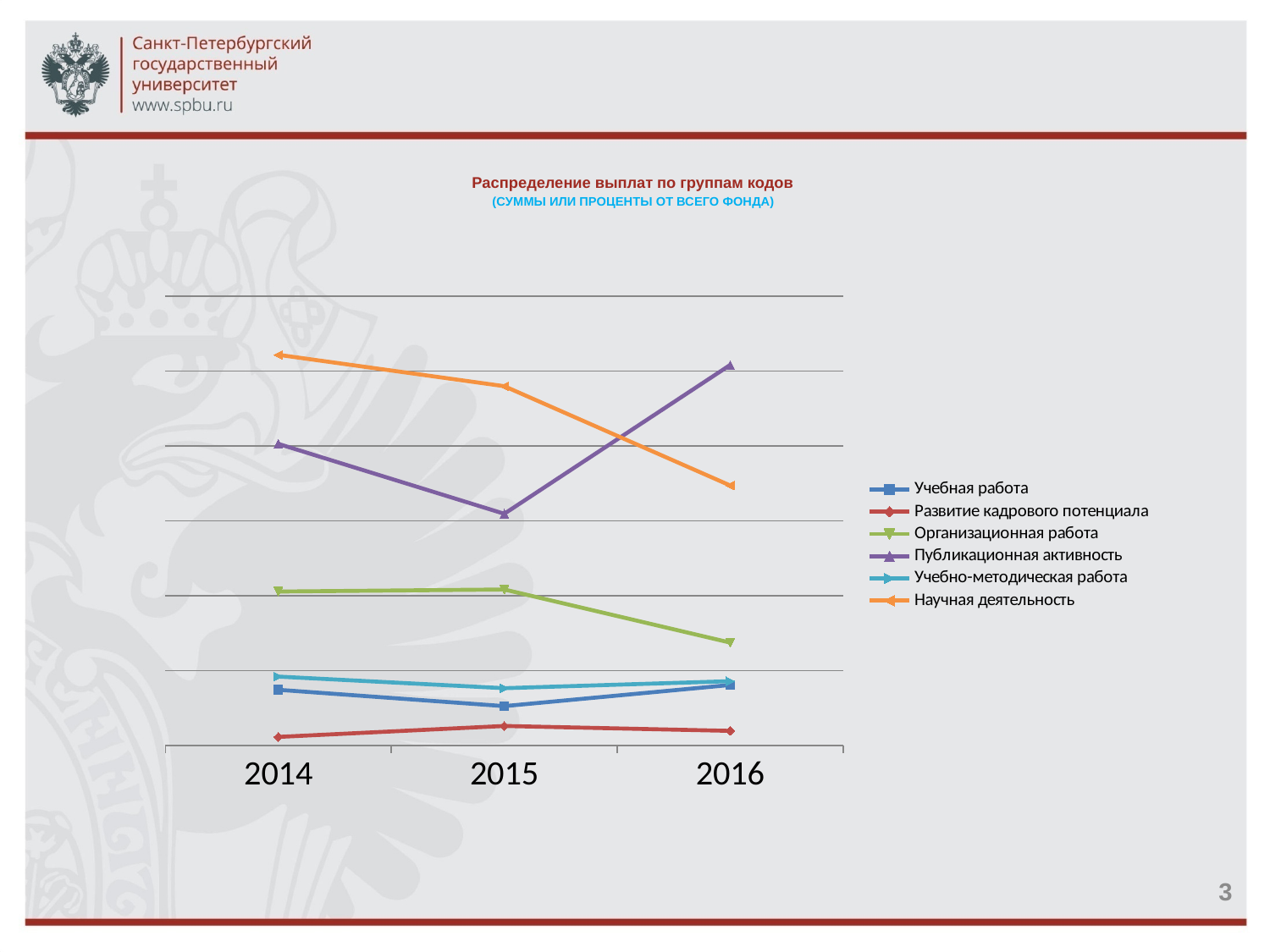
Which series has the lowest value in 2014? Развитие кадрового потенциала Between 2015 and 2016, does the line for Организационная работа rise or fall? fall Which series has the highest value in 2014? Научная деятельность Which series has the highest value in 2016? Публикационная активность How many years are plotted along the x axis of the chart? 3 In 2015, which is larger: Научная деятельность or Публикационная активность? Научная деятельность What is the title of the chart? Распределение выплат по группам кодов What kind of chart is shown on the slide? line chart In 2016, which is larger: Организационная работа or Учебная работа? Организационная работа How many series does the chart's legend list? 6 Does the line for Научная деятельность rise or fall from 2014 to 2016? fall Between 2015 and 2016, does the line for Публикационная активность rise or fall? rise